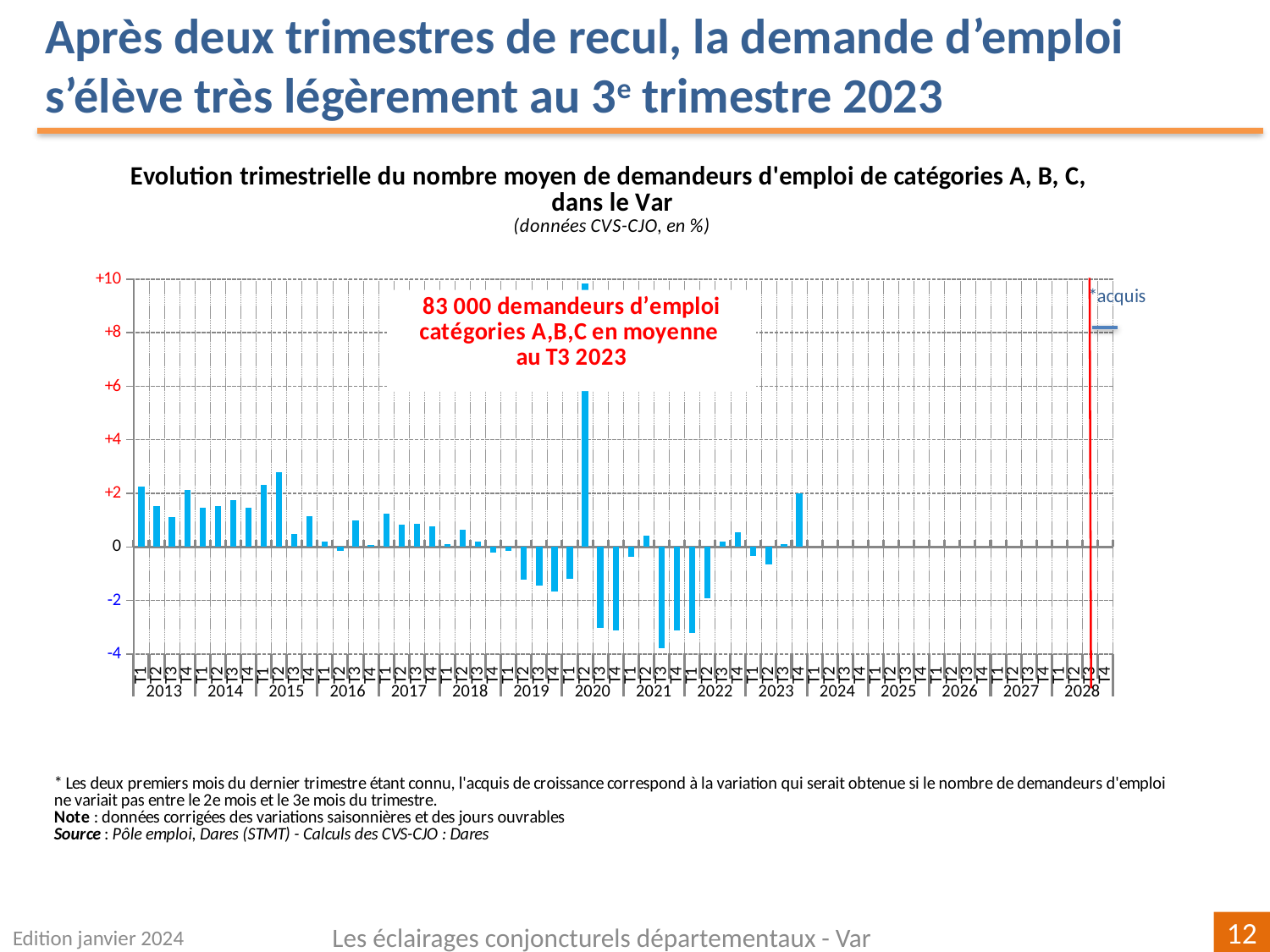
What kind of chart is shown on the slide? bar chart According to the red annotation on the chart, how many demandeurs d'emploi catégories A,B,C were there on average in T3 2023? 83 000 What is the highest value shown on the vertical axis of the chart? +10 Which is larger, the value for T2 2020 or the value for T2 2015? T2 2020 Is the value for T2 2015 greater or less than +2? greater Is the value for T2 2020 greater or less than +4? greater How many years are labelled along the x axis of the chart? 16 Which quarter has the highest bar in the chart? T2 2020 Is the value for T2 2021 greater or less than -2? greater Which quarter has the lowest bar in the chart? T3 2021 Which is larger, the value for T1 2013 or the value for T1 2014? T1 2013